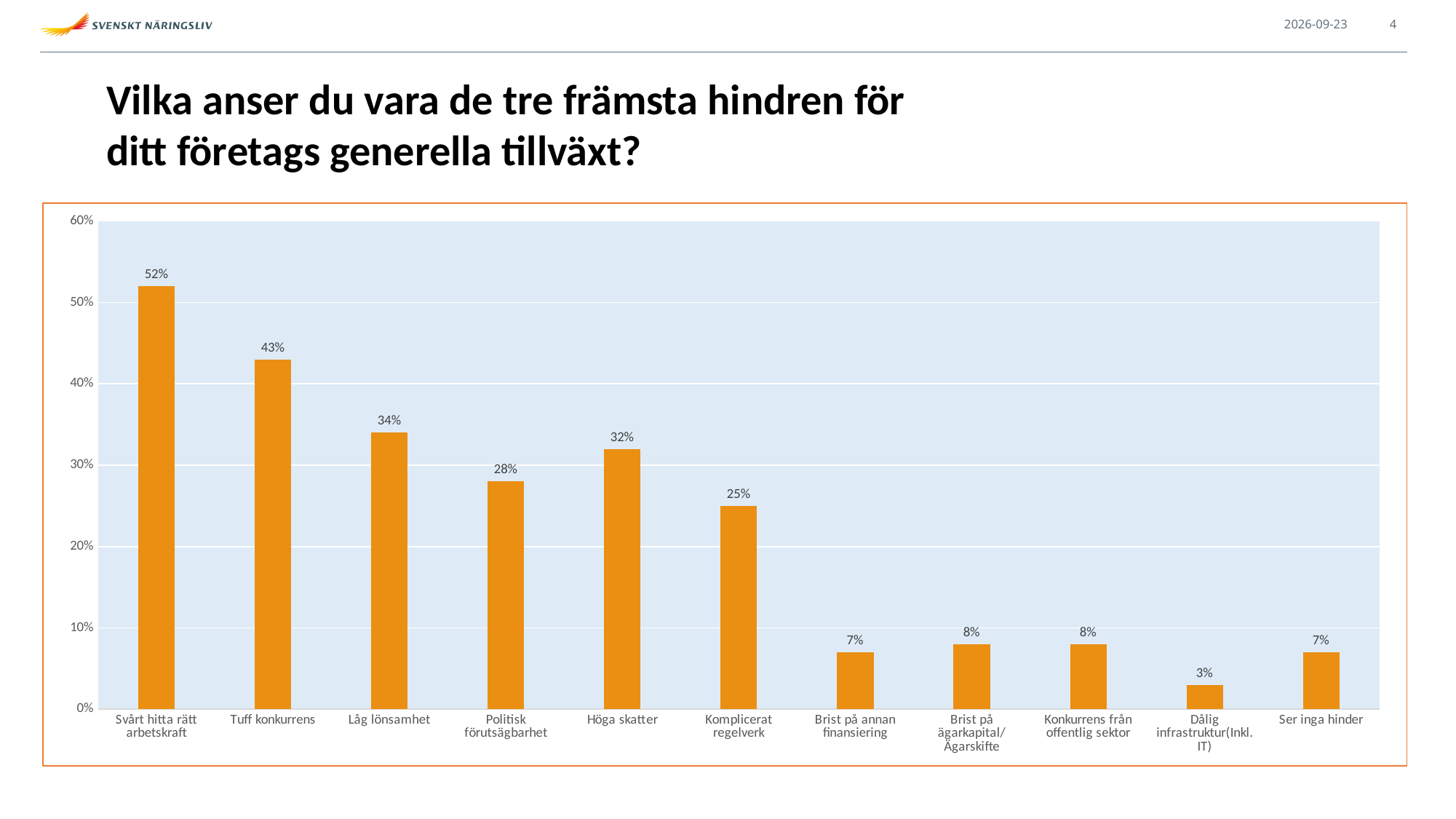
Which is larger, the value for Politisk förutsägbarhet or the value for Höga skatter? Höga skatter What is the value for Svårt hitta rätt arbetskraft? 52% What is the difference between the values for Tuff konkurrens and Låg lönsamhet? 9% What is the value for Höga skatter? 32% What is the value for Komplicerat regelverk? 25% How many categories are shown on the x axis? 11 What kind of chart is shown on the slide? Bar chart What is the title of the slide above the chart? Vilka anser du vara de tre främsta hindren för ditt företags generella tillväxt? Which category has the lowest value? Dålig infrastruktur(Inkl. IT) Which category has the highest value? Svårt hitta rätt arbetskraft What is the value for Dålig infrastruktur(Inkl. IT)? 3% Is the value for Tuff konkurrens greater or less than 40%? greater